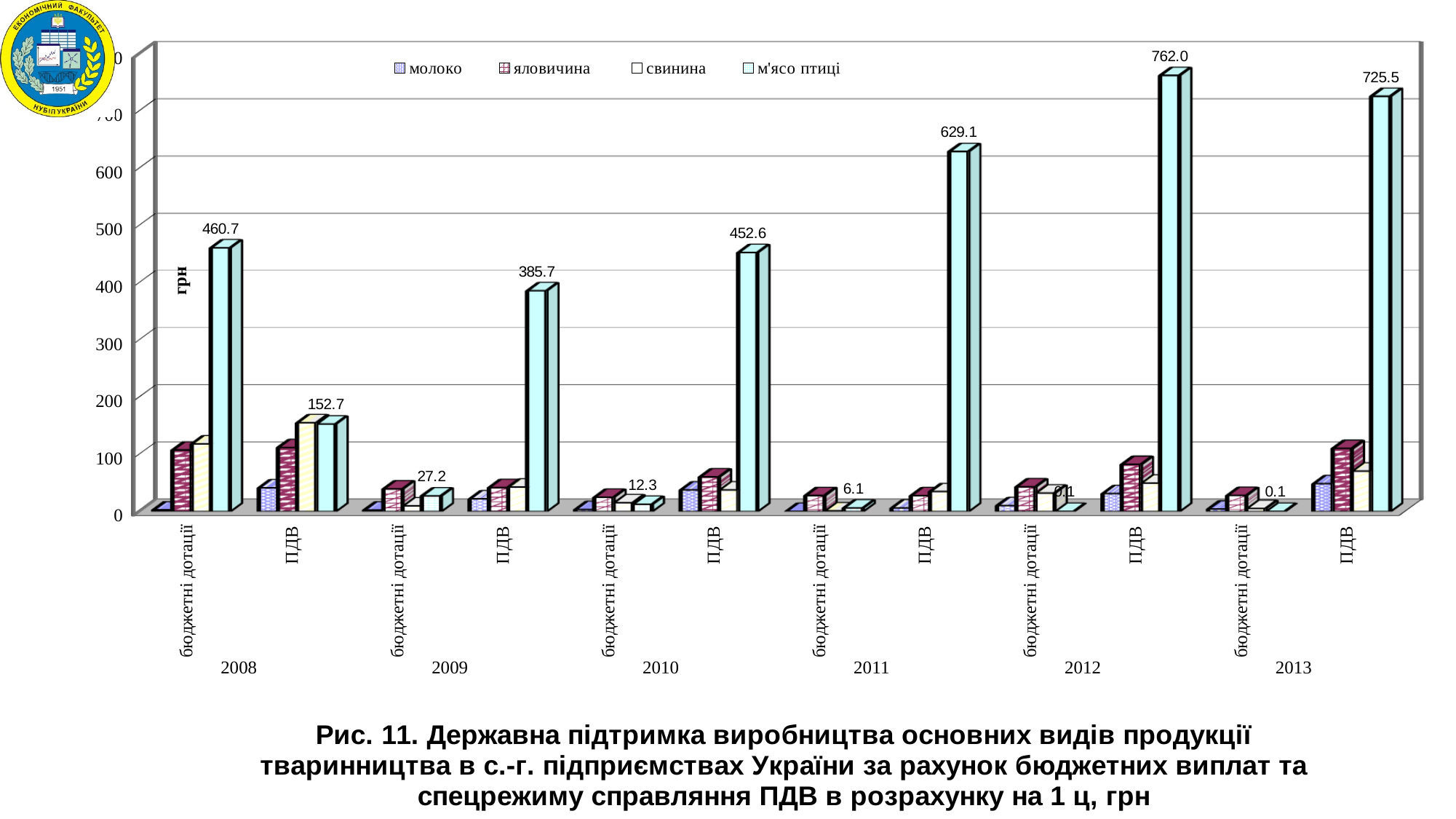
What is the value for м'ясо птиці under бюджетні дотації in 2008? 460.7 What unit is written on the vertical axis of the chart? грн What kind of chart is shown on the slide? bar chart What is the value for м'ясо птиці under бюджетні дотації in 2009? 27.2 What is the value for м'ясо птиці under ПДВ in 2013? 725.5 Which is larger for м'ясо птиці: ПДВ in 2011 or ПДВ in 2010? ПДВ in 2011 What is the value for м'ясо птиці under ПДВ in 2012? 762.0 What is the difference between the м'ясо птиці values for ПДВ in 2012 and ПДВ in 2013? 36.5 Does the м'ясо птиці value for ПДВ rise or fall from 2008 to 2012? rise In which category and year does м'ясо птиці reach its highest value? ПДВ, 2012 Is the value for свинина under ПДВ in 2008 greater or less than 200? less How many series does the legend list? 4